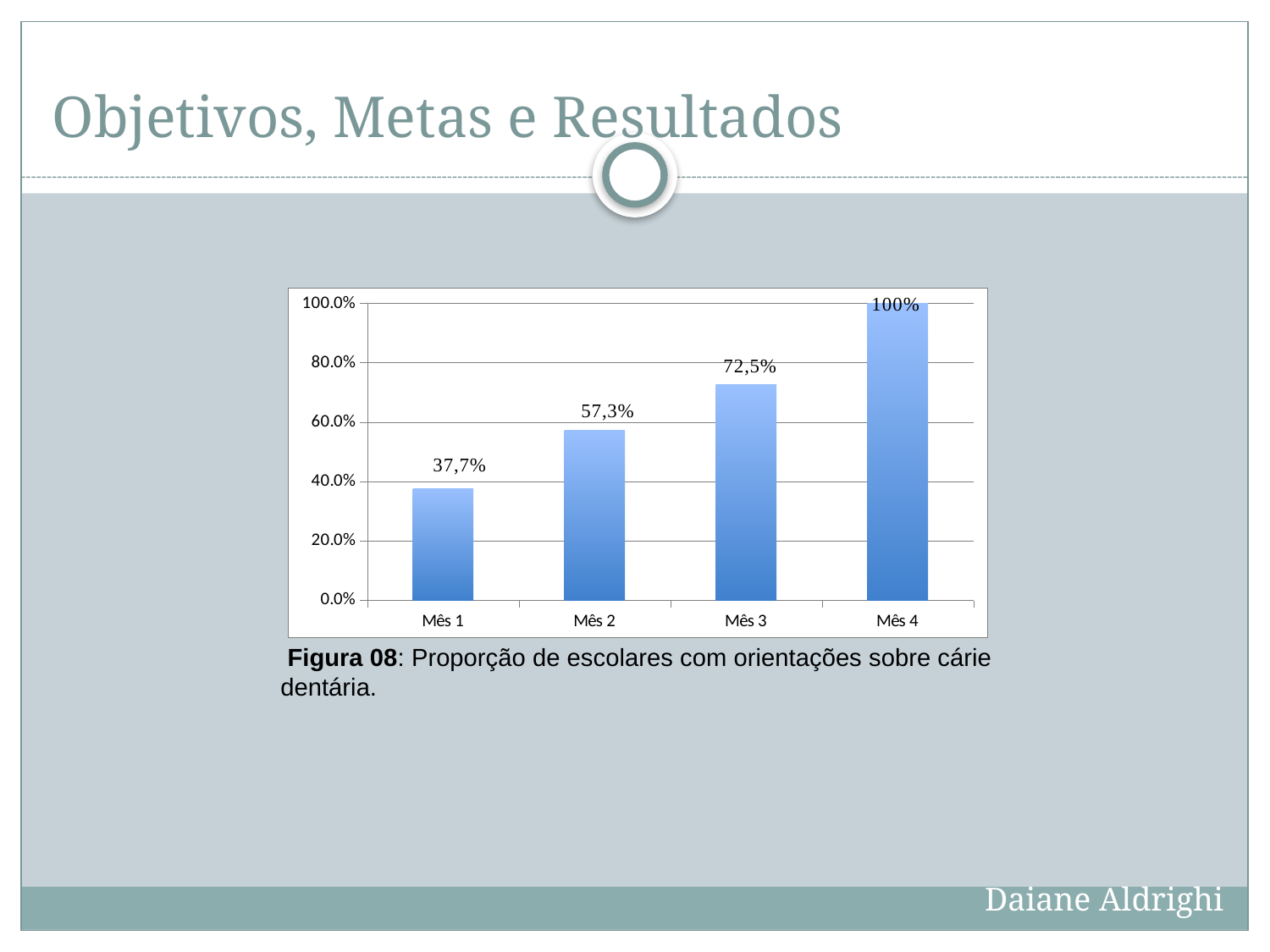
What kind of chart is shown on the slide? bar chart What is the value for Mês 1? 37,7% Which month has the lowest value? Mês 1 Is the value for Mês 3 greater or less than 60.0%? greater What is the difference between the values for Mês 2 and Mês 1? 19,6% What is the value for Mês 4? 100% Which is larger, the value for Mês 3 or the value for Mês 2? Mês 3 How many months are shown on the x axis? 4 Do the values rise or fall from Mês 1 to Mês 4? rise What is the value for Mês 2? 57,3% What is the value for Mês 3? 72,5% Which month has the highest value? Mês 4